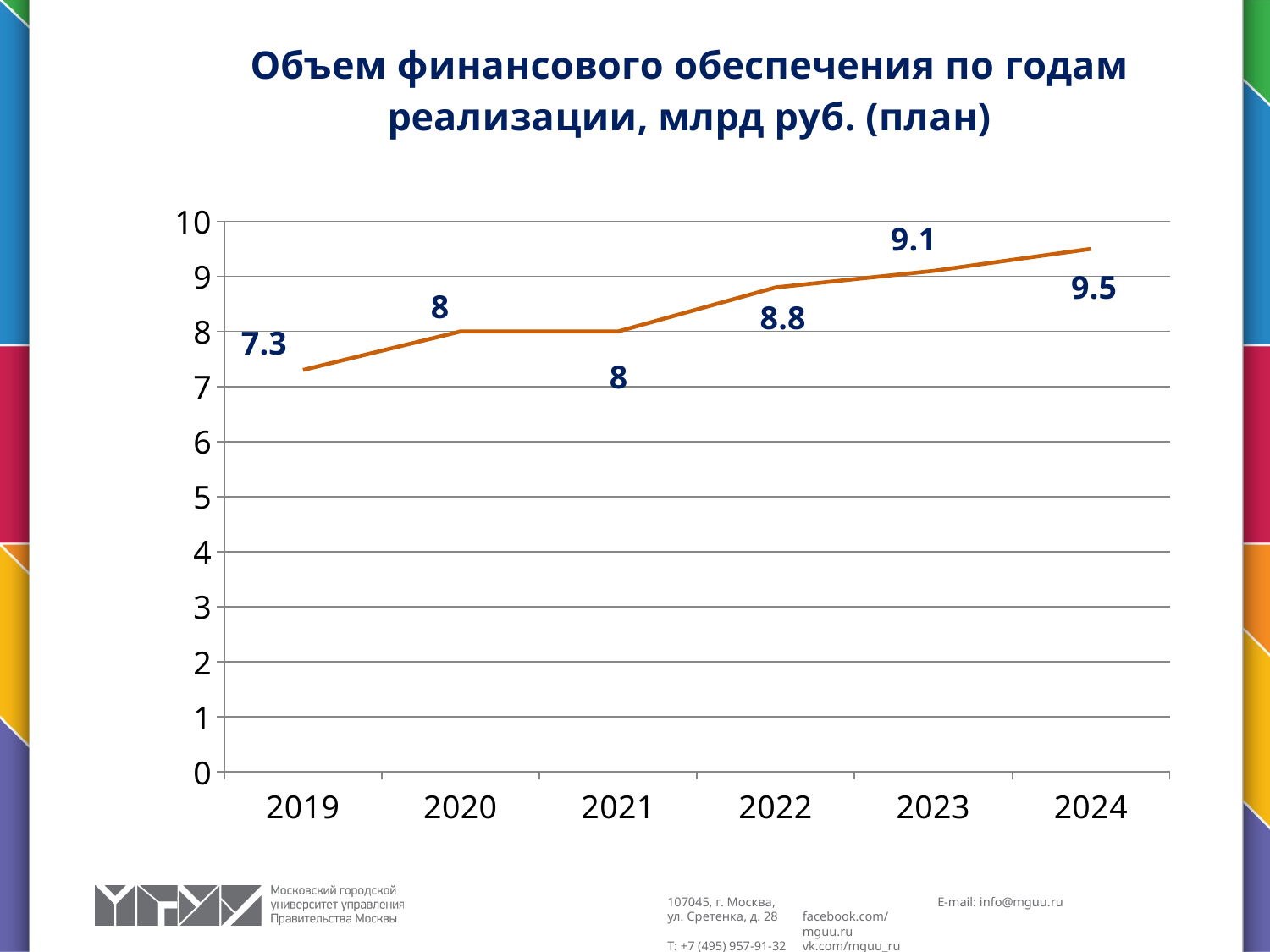
Which year has the highest value? 2024 How many years are plotted on the chart? 6 Which year has the lowest value? 2019 What is the value for 2022? 8.8 What kind of chart is shown on the slide? line chart What is the value for 2024? 9.5 Do the values generally rise or fall from 2019 to 2024? rise What is the difference between the values for 2022 and 2021? 0.8 Which is larger, the value for 2020 or the value for 2023? 2023 What is the value for 2019? 7.3 What is the value for 2023? 9.1 What is the difference between the values for 2024 and 2019? 2.2